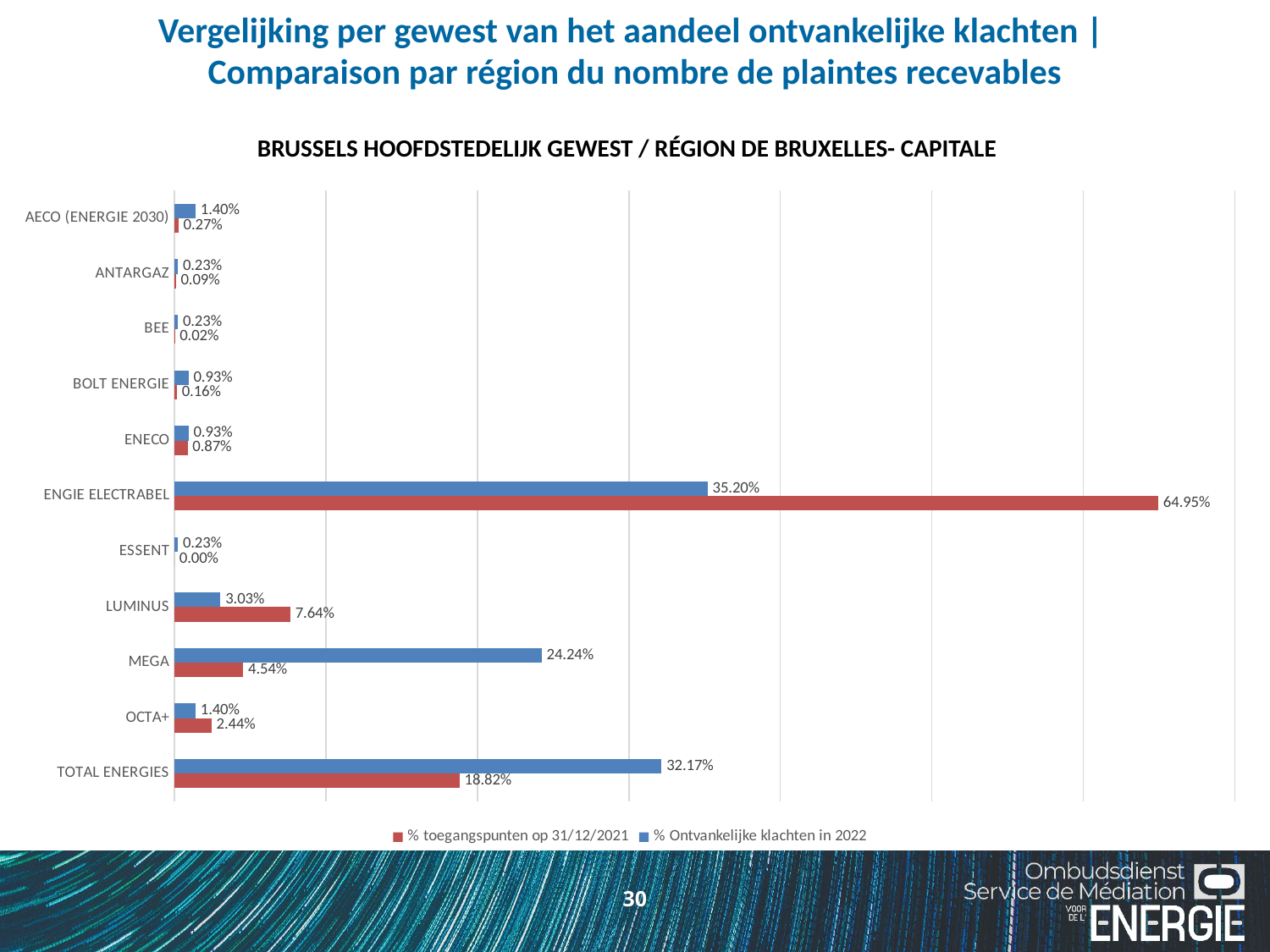
How many series does the legend list? 2 What kind of chart is shown on the slide? Bar chart What is the value of % toegangspunten op 31/12/2021 for LUMINUS? 7.64% What is the value of % Ontvankelijke klachten in 2022 for ENGIE ELECTRABEL? 35.20% What is the subtitle of the chart? BRUSSELS HOOFDSTEDELIJK GEWEST / RÉGION DE BRUXELLES- CAPITALE How many categories (suppliers) are shown on the chart? 11 Is the value of % toegangspunten op 31/12/2021 for ENGIE ELECTRABEL greater or less than 60%? greater Which category has the lowest value for % toegangspunten op 31/12/2021? ESSENT For TOTAL ENERGIES, which is larger: % toegangspunten op 31/12/2021 or % Ontvankelijke klachten in 2022? % Ontvankelijke klachten in 2022 Which category has the highest value for % toegangspunten op 31/12/2021? ENGIE ELECTRABEL What is the value of % Ontvankelijke klachten in 2022 for MEGA? 24.24% What is the difference between the % toegangspunten op 31/12/2021 and the % Ontvankelijke klachten in 2022 for ENGIE ELECTRABEL? 29.75%